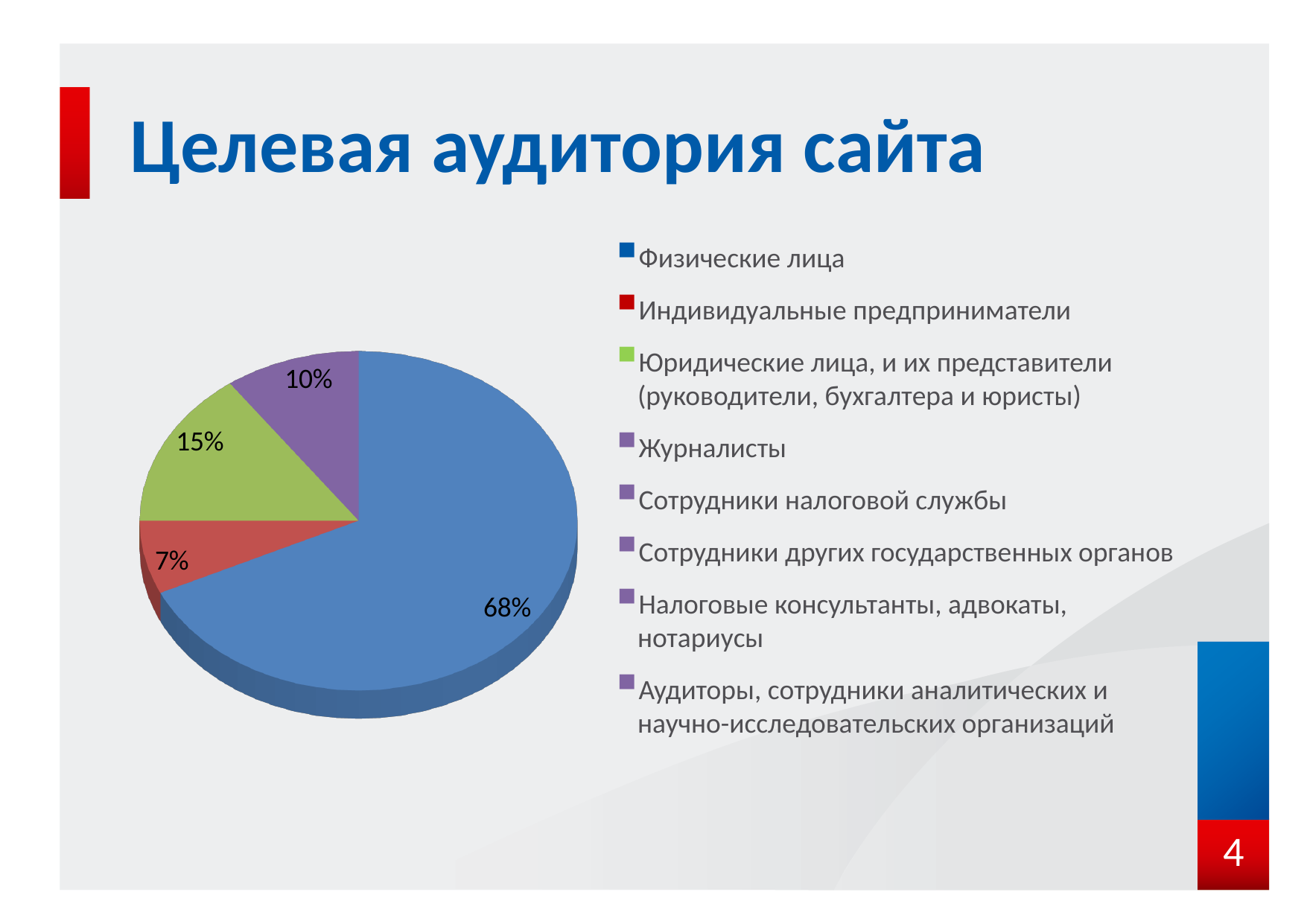
What percentage is shown for Индивидуальные предприниматели? 7% What is the title of the slide containing the chart? Целевая аудитория сайта What type of chart is shown on the slide? Pie chart Which category has the largest slice of the pie? Физические лица Which is larger: the slice for Юридические лица or the slice for Индивидуальные предприниматели? Юридические лица What percentage is shown on the purple slice of the pie? 10% How many entries does the legend list? 8 What share of the pie is labelled for Физические лица? 68% How many slices does the pie chart have? 4 Which category has the smallest slice of the pie? Индивидуальные предприниматели By how many percentage points does the Физические лица slice exceed the Юридические лица slice? 53 percentage points What percentage is shown for Юридические лица, и их представители (руководители, бухгалтера и юристы)? 15%